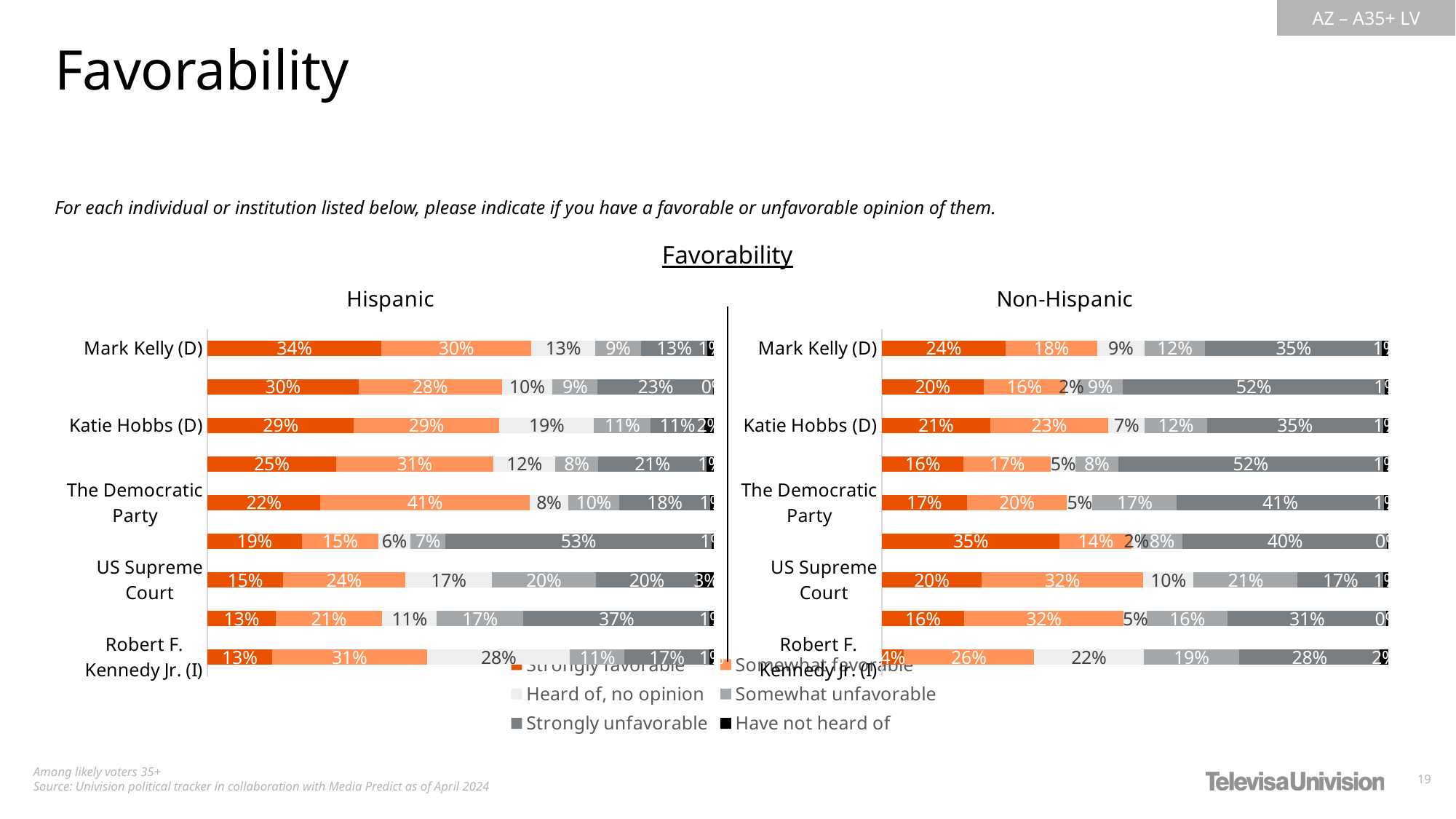
In the Non-Hispanic chart, what is the strongly favorable value for Katie Hobbs (D)? 21% In the Non-Hispanic chart, what is the somewhat favorable value for the US Supreme Court? 32% In the Hispanic chart, what percentage have heard of Robert F. Kennedy Jr. (I) but have no opinion? 28% In the Non-Hispanic chart, what percentage of respondents are strongly unfavorable toward Mark Kelly (D)? 35% How much higher is the somewhat favorable value for The Democratic Party in the Hispanic chart than in the Non-Hispanic chart? 21 percentage points How many series does the legend list for the favorability charts? 6 In the Non-Hispanic chart, what is the strongly unfavorable value for The Democratic Party? 41% Is the strongly favorable value for Mark Kelly (D) larger in the Hispanic chart or the Non-Hispanic chart? Hispanic In the Hispanic chart, which labeled individual or institution has the highest strongly favorable value? Mark Kelly (D) In the Hispanic chart, what is the somewhat favorable value for The Democratic Party? 41% What kind of chart is used to show favorability for the Hispanic and Non-Hispanic groups? Stacked bar chart In the Hispanic chart, what percentage of respondents are strongly favorable toward Mark Kelly (D)? 34%